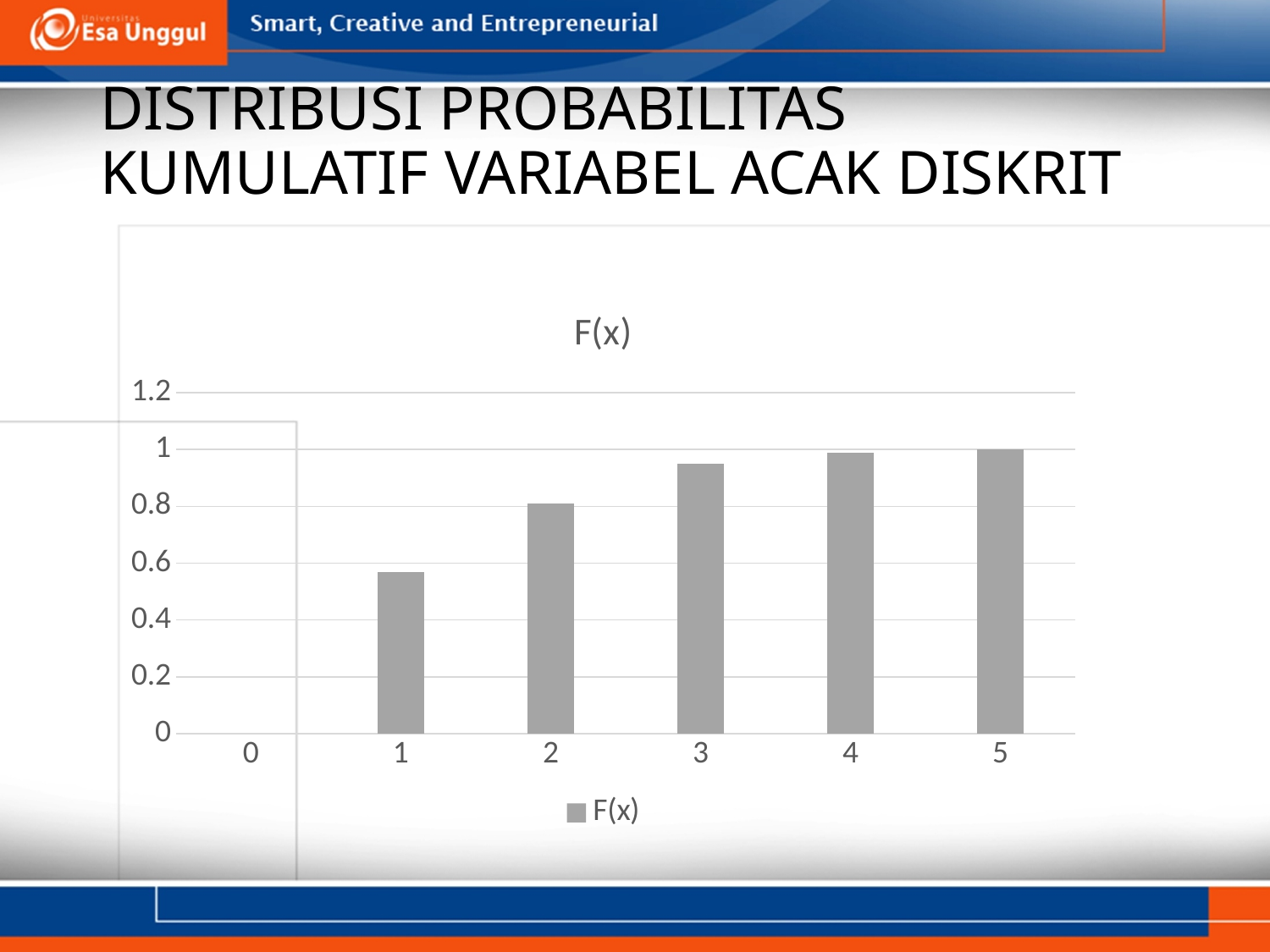
How many categories are shown on the x axis? 6 How many series does the legend list? 1 Do the values rise or fall as x increases from 1 to 5? rise What kind of chart is shown on the slide? bar chart What colour are the bars in the chart? gray What is the value of F(x) for category 5? 1 Is the value for category 1 greater or less than 0.6? less Is the value for category 2 greater or less than 0.6? greater Is the value for category 3 greater or less than 0.8? greater What is the title of the chart? F(x) Which is larger, the value for category 1 or the value for category 2? category 2